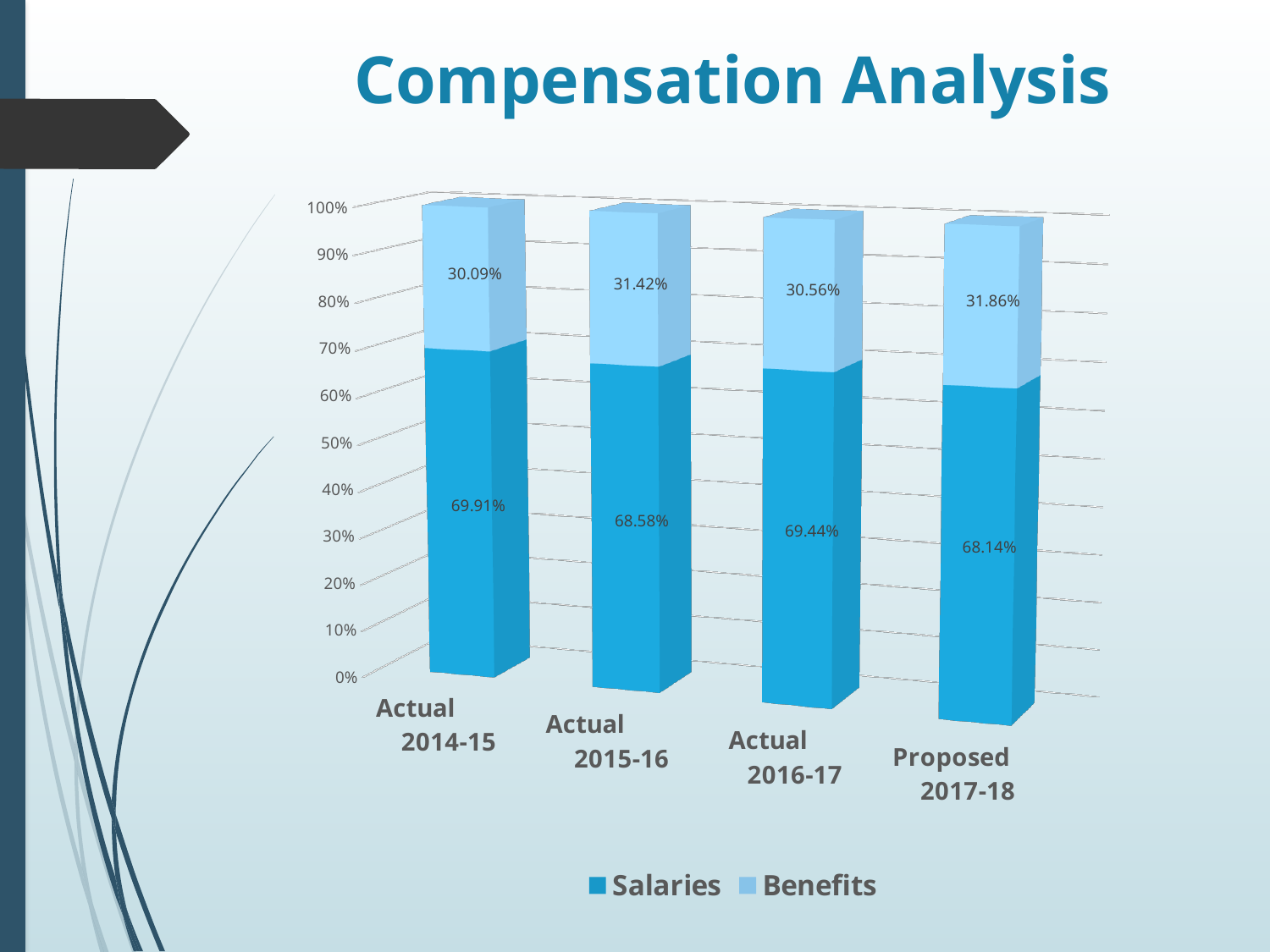
What is the Benefits value for Proposed 2017-18? 31.86% What is the difference between the Salaries values for Actual 2014-15 and Proposed 2017-18? 1.77% What is the Salaries value for Actual 2016-17? 69.44% How many categories are shown on the x axis? 4 Which category has the highest Salaries value? Actual 2014-15 How many series does the legend list? 2 What kind of chart is shown? Stacked bar chart What is the title of the chart? Compensation Analysis What is the Salaries value for Actual 2014-15? 69.91% Which category has the lowest Benefits value? Actual 2014-15 What is the Benefits value for Actual 2015-16? 31.42% Is the Benefits value larger for Actual 2015-16 or Actual 2016-17? Actual 2015-16